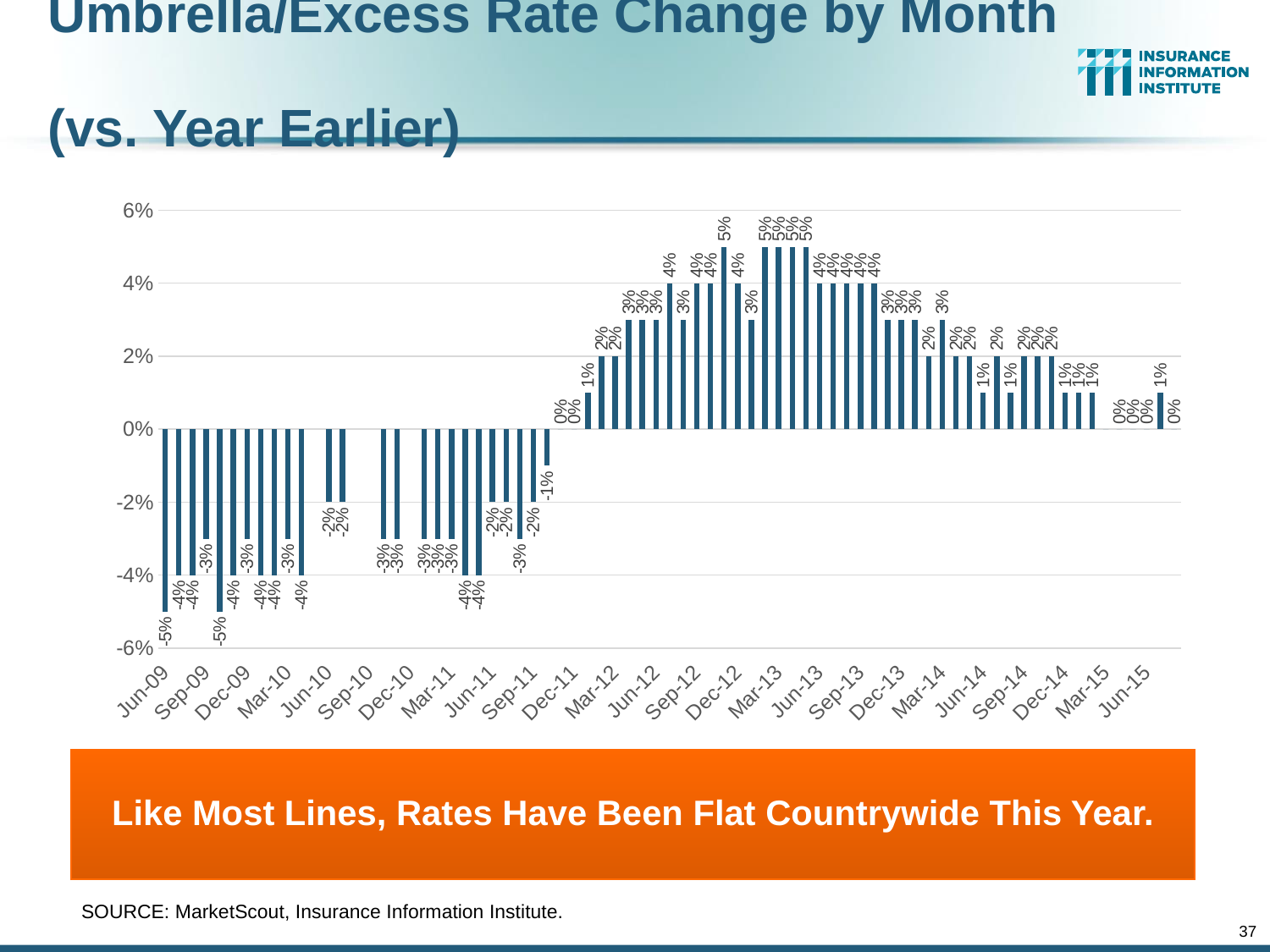
Which is larger, the rate change for Jun-12 or for Jun-14? Jun-12 How many month labels are shown on the x axis? 25 What is the umbrella/excess rate change for Jun-09? -5% Do the rate changes generally rise or fall from Jun-09 to Mar-13? Rise What is the highest rate change value shown on the chart? 5% What is the umbrella/excess rate change for Mar-13? 5% What is the difference in percentage points between the rate change for Mar-13 and for Jun-09? 10 percentage points What kind of chart is shown on the slide? Bar chart What is the umbrella/excess rate change for Jun-12? 3% What is the lowest rate change value shown on the chart? -5% What is the umbrella/excess rate change for Jun-15? 0% What is the umbrella/excess rate change for Sep-14? 2%